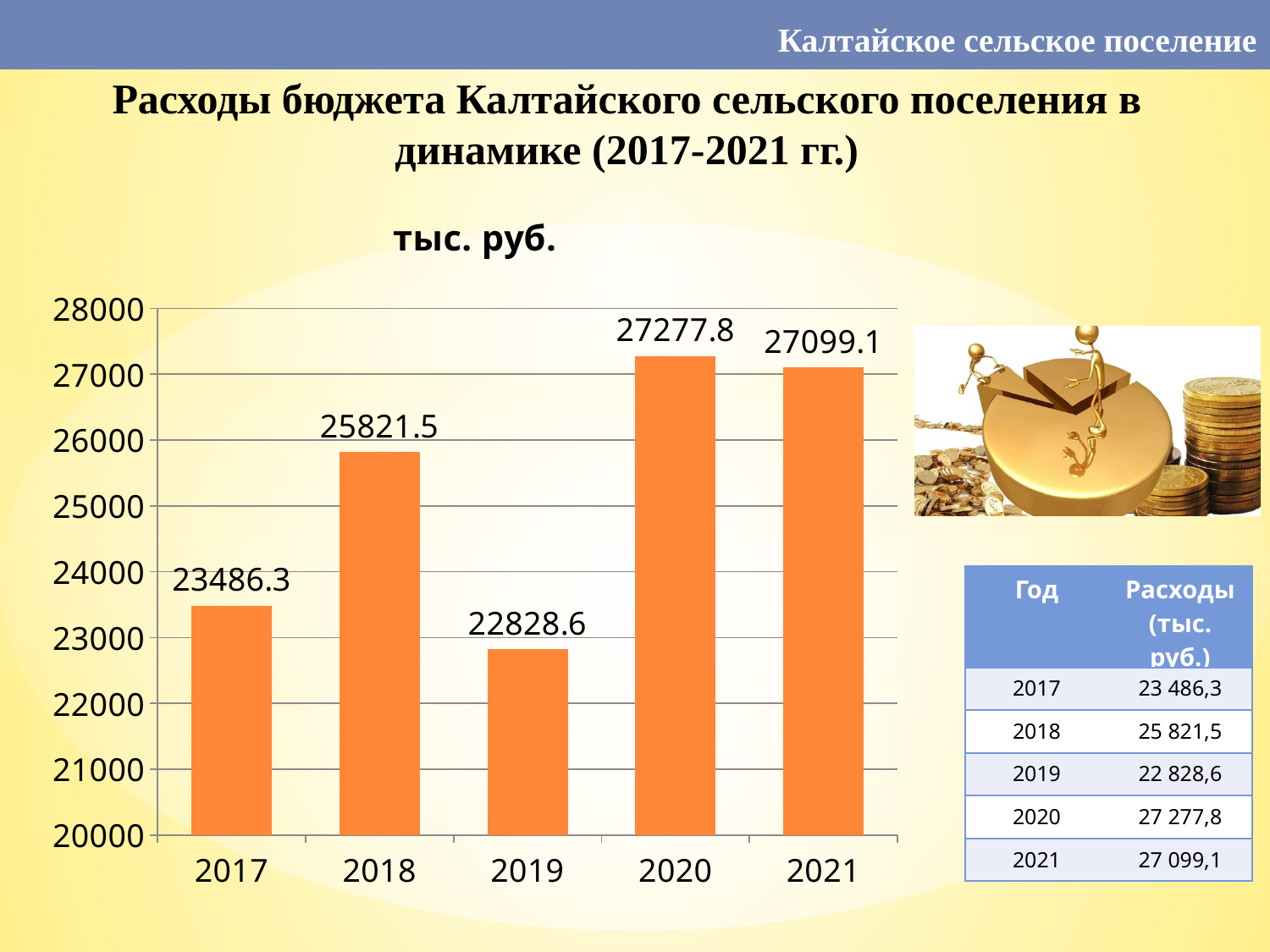
Which year has the highest value? 2020 What kind of chart is shown? bar chart What is the value for 2017? 23486.3 What is the title shown above the chart? тыс. руб. Which is larger, the value for 2020 or the value for 2021? 2020 How many years are shown on the x axis? 5 Is the value for 2018 greater or less than 25000? greater What is the difference between the values for 2020 and 2019? 4449.2 Which year has the lowest value? 2019 What is the value for 2019? 22828.6 What is the value for 2021? 27099.1 What is the difference between the values for 2018 and 2017? 2335.2